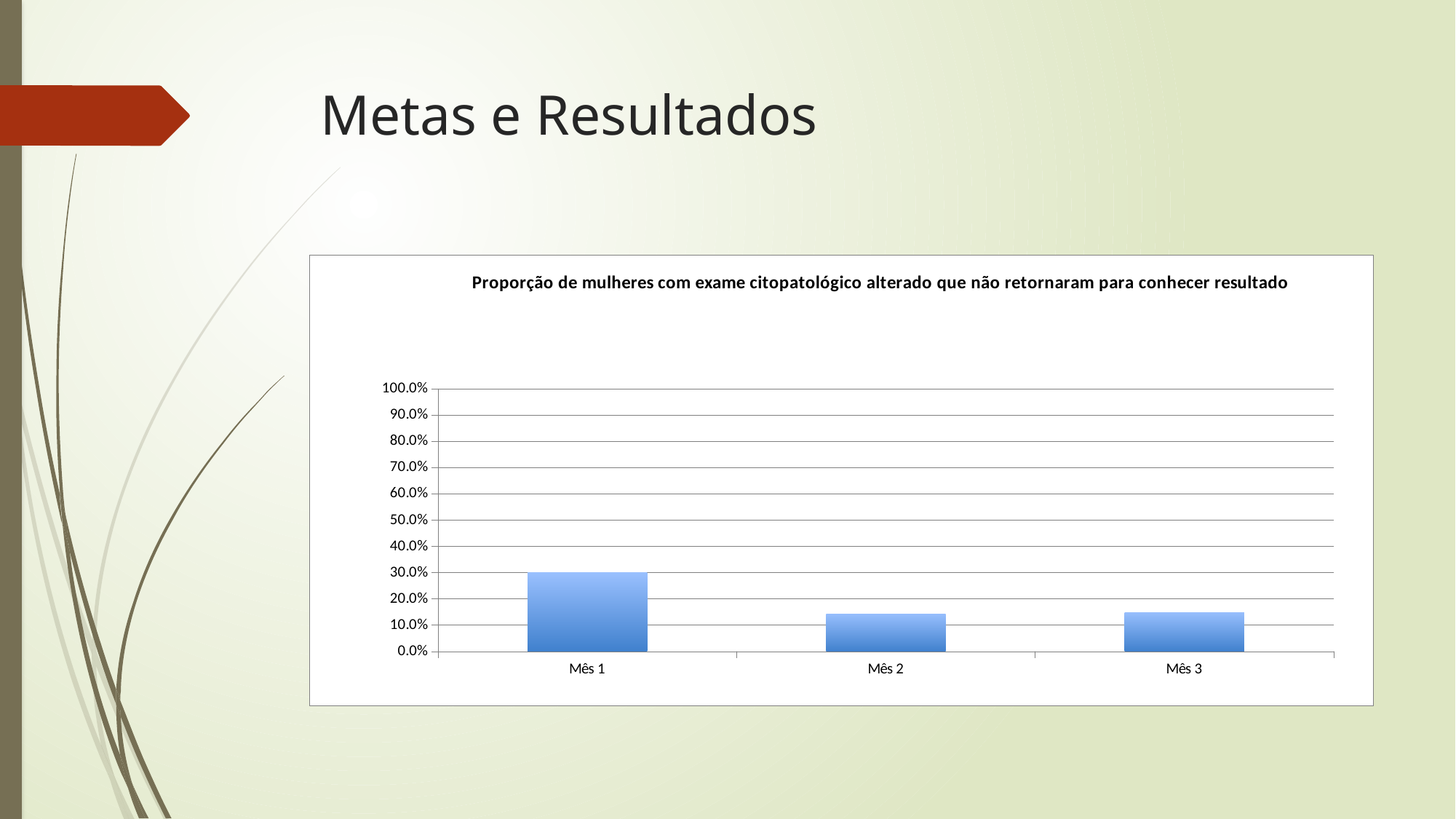
What is the value for Mês 1 in the chart? 30.0% How many months (categories) are shown on the x axis of the chart? 3 What is the title of the chart? Proporção de mulheres com exame citopatológico alterado que não retornaram para conhecer resultado Is the value for Mês 1 greater or less than 20.0%? greater Is the value for Mês 2 greater or less than 20.0%? less What kind of chart is shown on the slide? bar chart Which is larger, the value for Mês 1 or the value for Mês 2? Mês 1 Is the value for Mês 2 greater or less than 10.0%? greater Does the value fall or rise from Mês 1 to Mês 2? fall Which month has the highest proportion in the chart? Mês 1